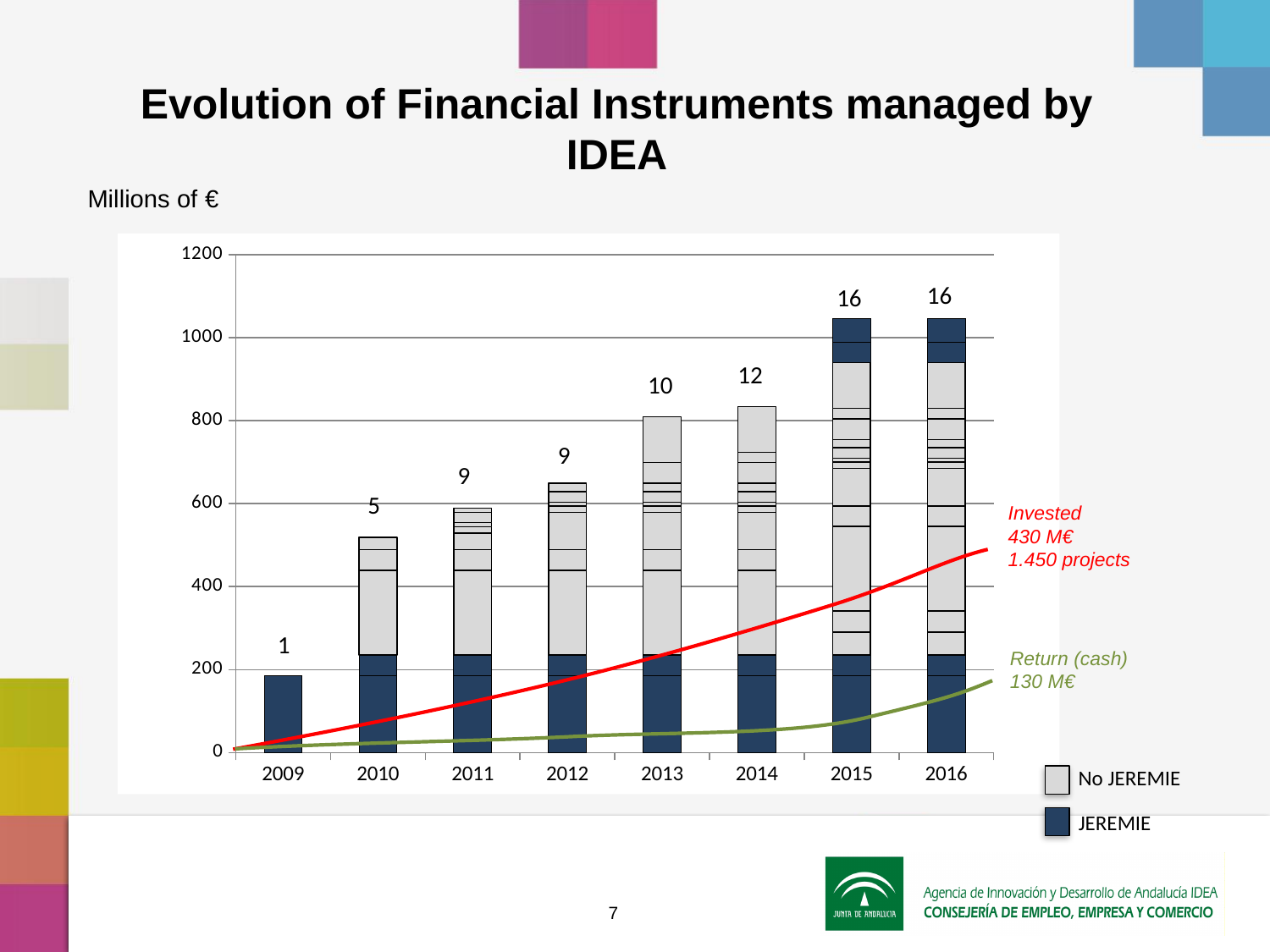
Do the total bar heights rise or fall from 2009 to 2016? rise How many series does the chart legend list? 2 What number is printed above the bar for 2010? 5 How many years are shown along the x axis of the chart? 8 Is the total bar for 2012 greater or less than 600? greater What number is printed above the bar for 2016? 16 Which year has a taller total bar, 2012 or 2015? 2015 Is the total bar for 2016 greater or less than 1000? greater Is the total bar for 2009 greater or less than 200? less What number is printed above the bar for 2013? 10 What kind of chart is shown on the slide? bar chart Which year has the lowest total bar in the chart? 2009